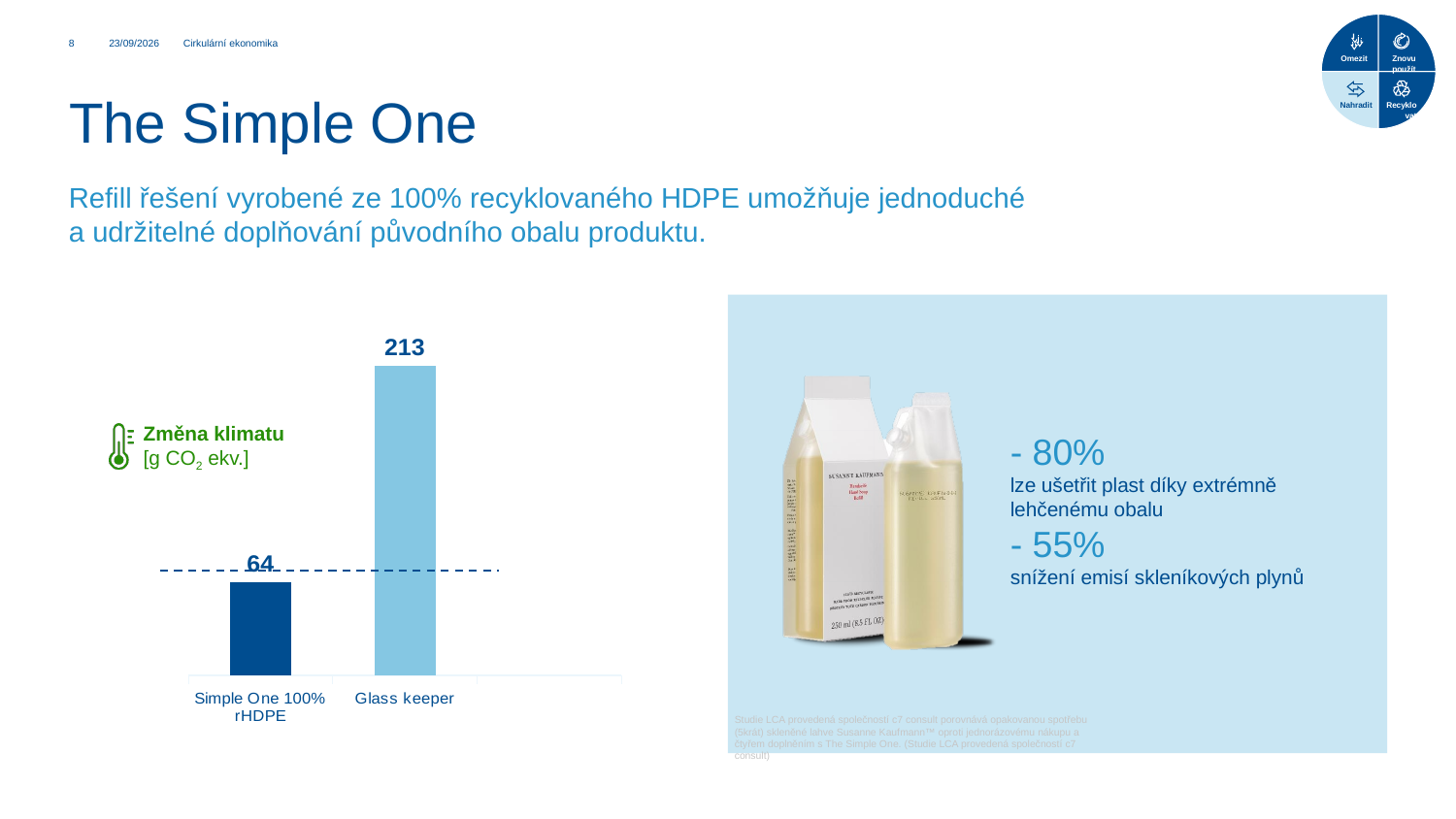
What is the value for Simple One 100% rHDPE in the bar chart? 64 What is the difference between the values for Glass keeper and Simple One 100% rHDPE? 149 What is the total of the two bars in the chart? 277 Which is larger, the value for Simple One 100% rHDPE or the value for Glass keeper? Glass keeper Which category has the highest value in the bar chart? Glass keeper How many categories are shown in the bar chart? 2 What is the label shown next to the thermometer icon above the chart? Změna klimatu Which category has the lowest value in the bar chart? Simple One 100% rHDPE What kind of chart is shown on the slide? Bar chart What unit is given for the values in the bar chart? g CO2 ekv. What is the value for Glass keeper in the bar chart? 213